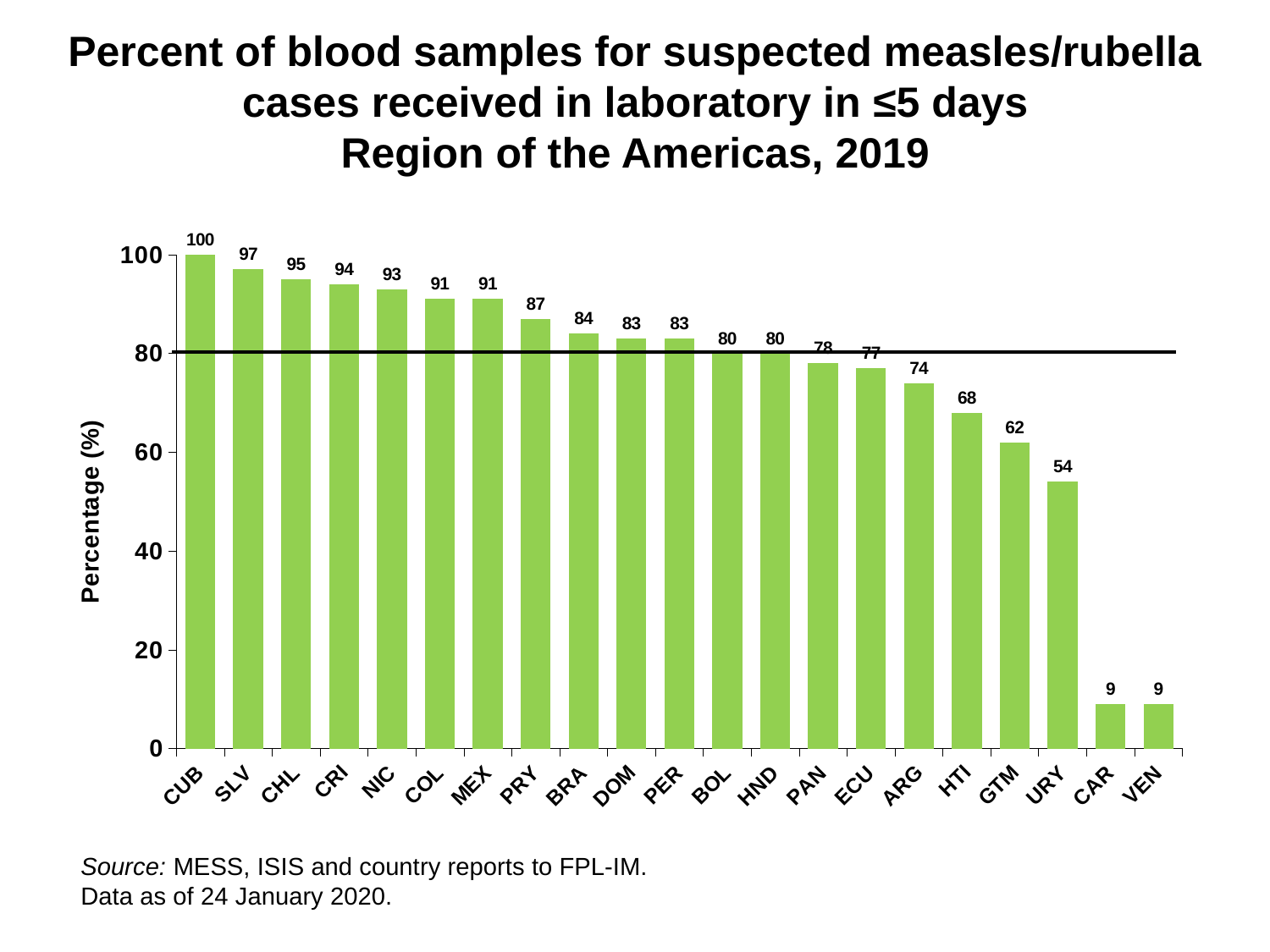
What kind of chart is this? bar chart Do the values rise or fall from left to right along the x axis? fall What is the difference between the values for CUB and VEN? 91 What is the difference between the values for ARG and GTM? 12 How many countries are shown on the x axis? 21 Which country has the highest value? CUB Is the value for ECU greater or less than 80? less What is the value for PRY? 87 Which has a larger value, BRA or DOM? BRA What is the label of the y axis? Percentage (%) What is the value for URY? 54 What is the value for HTI? 68